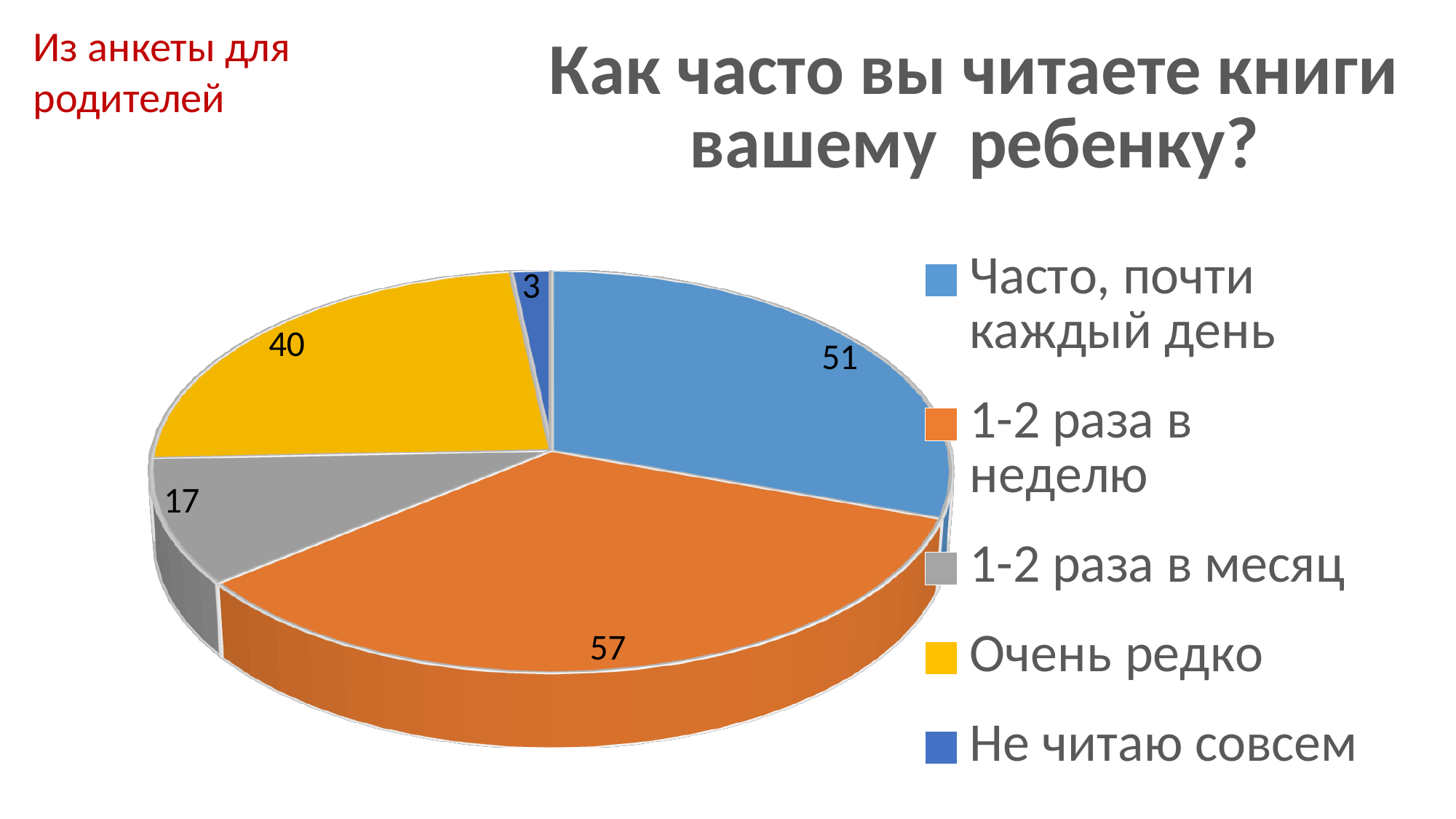
What is the difference between the values for "1-2 раза в неделю" and "Часто, почти каждый день"? 6 Which category has the smallest slice? Не читаю совсем How many categories does the pie chart have? 5 Which category has the largest slice? 1-2 раза в неделю What is the value for "Не читаю совсем"? 3 What is the title of the chart? Как часто вы читаете книги вашему ребенку? What is the value for "1-2 раза в неделю"? 57 What is the value for "Очень редко"? 40 What type of chart is shown on the slide? Pie chart What is the value for "Часто, почти каждый день"? 51 What is the total of all the values shown in the pie chart? 168 Which is larger: the value for "Очень редко" or the value for "1-2 раза в месяц"? Очень редко